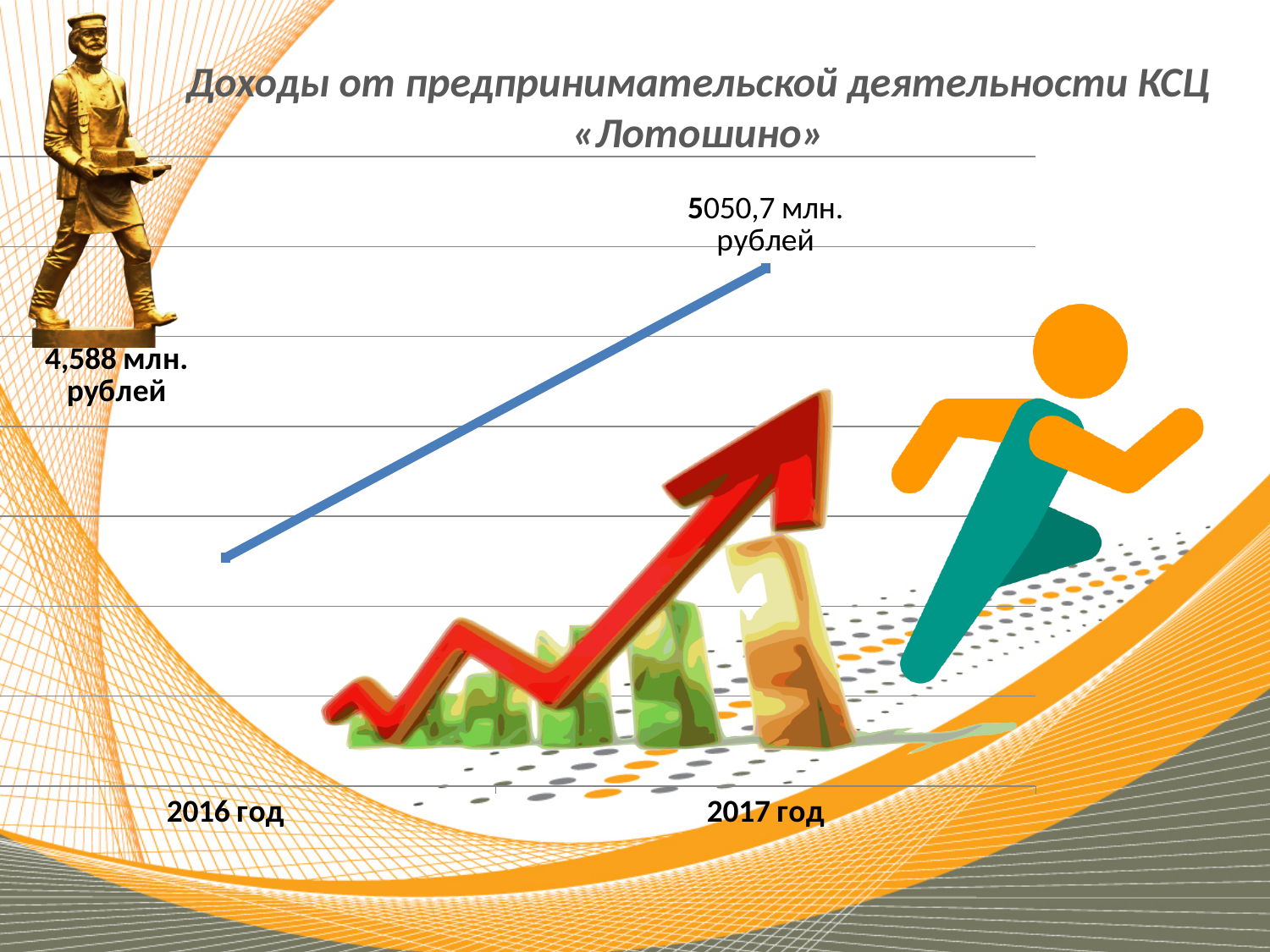
What colour is the plotted line on the chart? blue Do the values rise or fall from 2016 год to 2017 год? rise Which year has the lower value? 2016 год What is the value shown for 2016 год? 4,588 млн. рублей Is the value for 2017 год larger or smaller than the value for 2016 год? larger Which year has the higher value? 2017 год How many data points are plotted on the chart? 2 What kind of chart is shown on the slide? line chart What is the value shown for 2017 год? 5050,7 млн. рублей What is the title of the chart? Доходы от предпринимательской деятельности КСЦ «Лотошино»